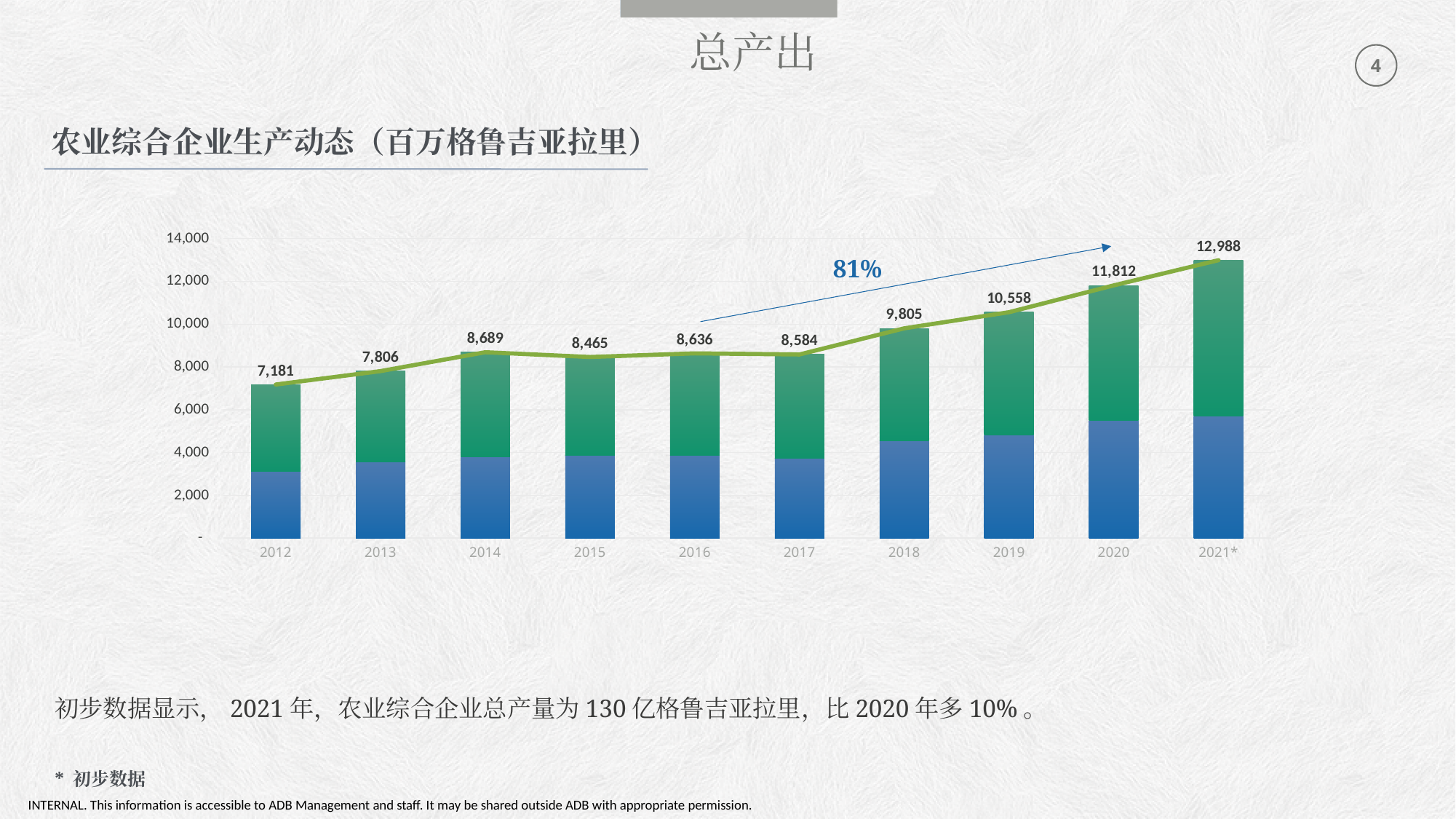
What is the total value shown for 2012? 7,181 What is the difference between the total values for 2021* and 2020? 1,176 Is the blue (bottom) segment of the 2012 bar greater or less than 4,000? less Do the total values rise or fall from 2017 to 2021*? rise What percentage is written next to the arrow annotation on the chart? 81% What kind of chart is this? Stacked bar chart with a line Which year has the lowest total value? 2012 What is the total value shown for 2018? 9,805 How many years are shown on the x axis? 10 What is the total value shown for 2021*? 12,988 Which year has the highest total value? 2021* Which is larger, the total value for 2014 or for 2015? 2014